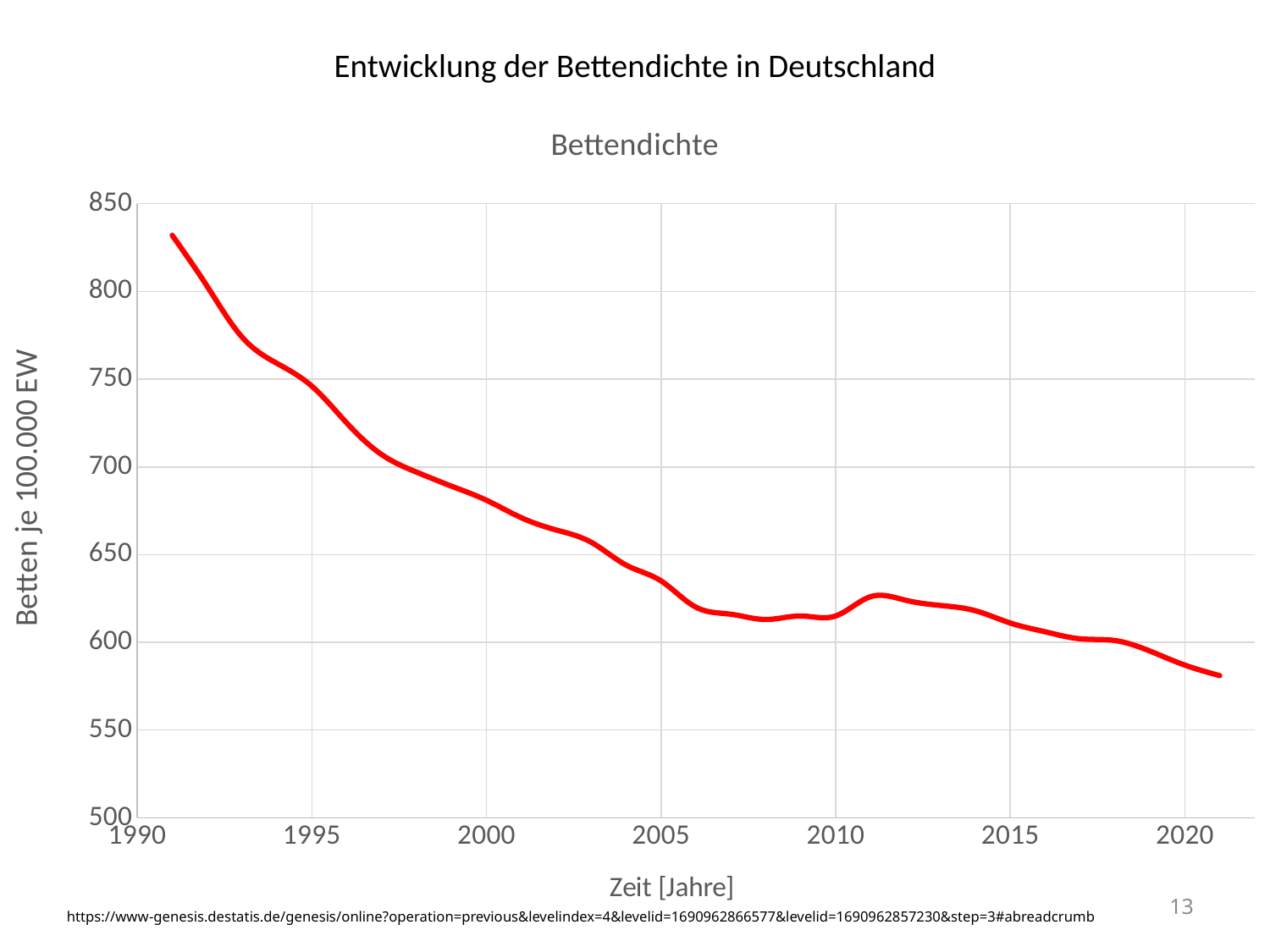
What is the label of the y axis? Betten je 100.000 EW Is the value for 2021 greater or less than 600? less Is the value for 2000 greater or less than 700? less Is the value for 2010 greater or less than 650? less What kind of chart is shown on the slide? line chart What is the title of the chart? Bettendichte Does the bed density generally rise or fall from 1990 to 2020? fall Which year has the highest bed density on the chart? 1991 Which is larger, the value for 1995 or the value for 2005? 1995